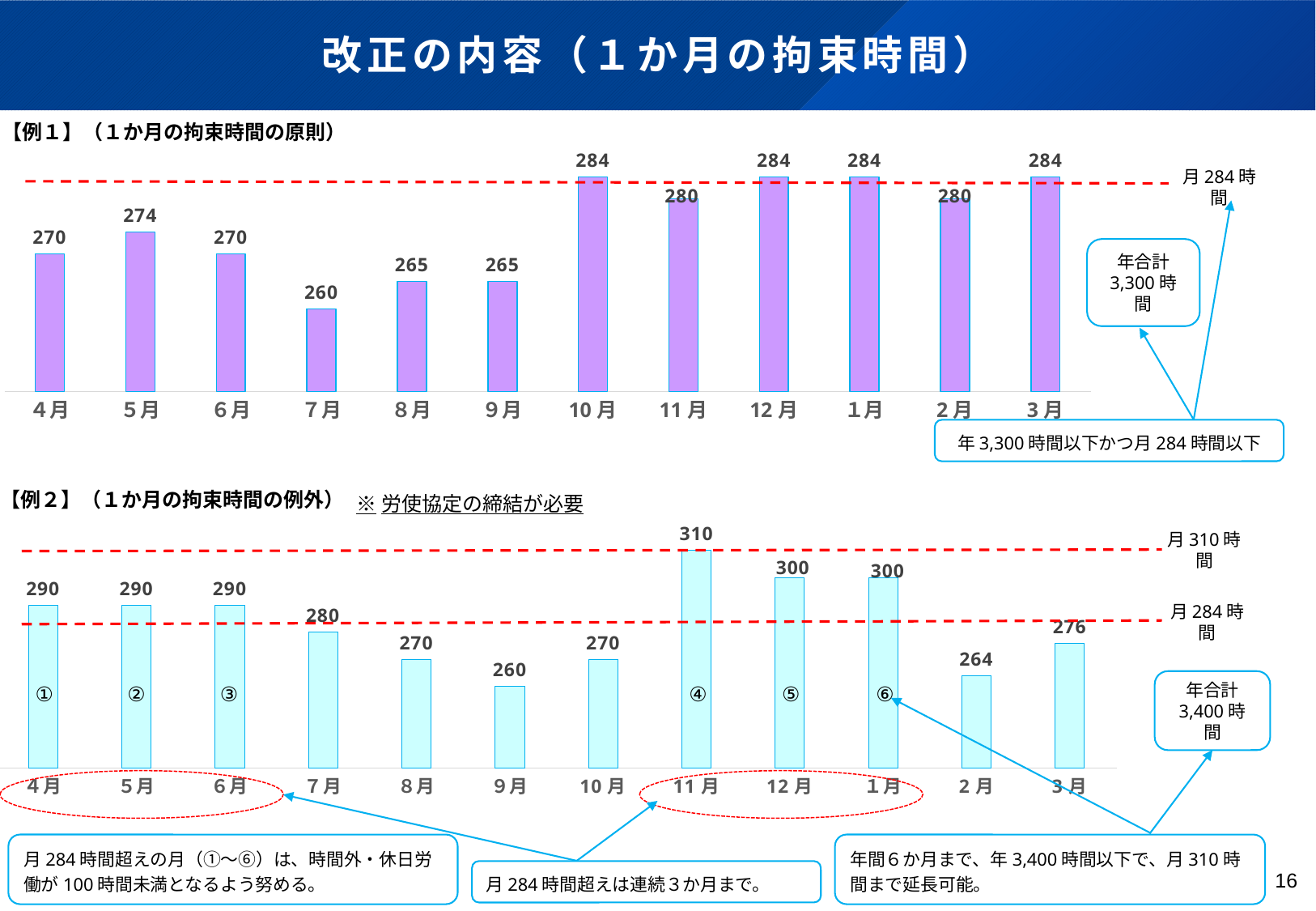
In the top chart (【例1】), what monthly limit does the red dashed line represent? 月284時間 In the bottom chart (【例2】), which month has the lowest value? 9月 In the bottom chart (【例2】), which is larger, the value for 2月 or the value for 3月? 3月 In the top chart (【例1】), which month has the lowest value? 7月 In the top chart (【例1】), what is the difference between the values for 10月 and 7月? 24 In the top chart (【例1】), what is the value for 5月? 274 In the bottom chart (【例2】), what is the difference between the values for 12月 and 2月? 36 In the top chart (【例1】), how many months are plotted? 12 In the bottom chart (【例2】), which month has the highest value? 11月 In the top chart (【例1】), what kind of chart is shown? Bar chart In the bottom chart (【例2】), do the values rise or fall from 4月 to 9月? Fall In the bottom chart (【例2】), what is the value for 11月? 310